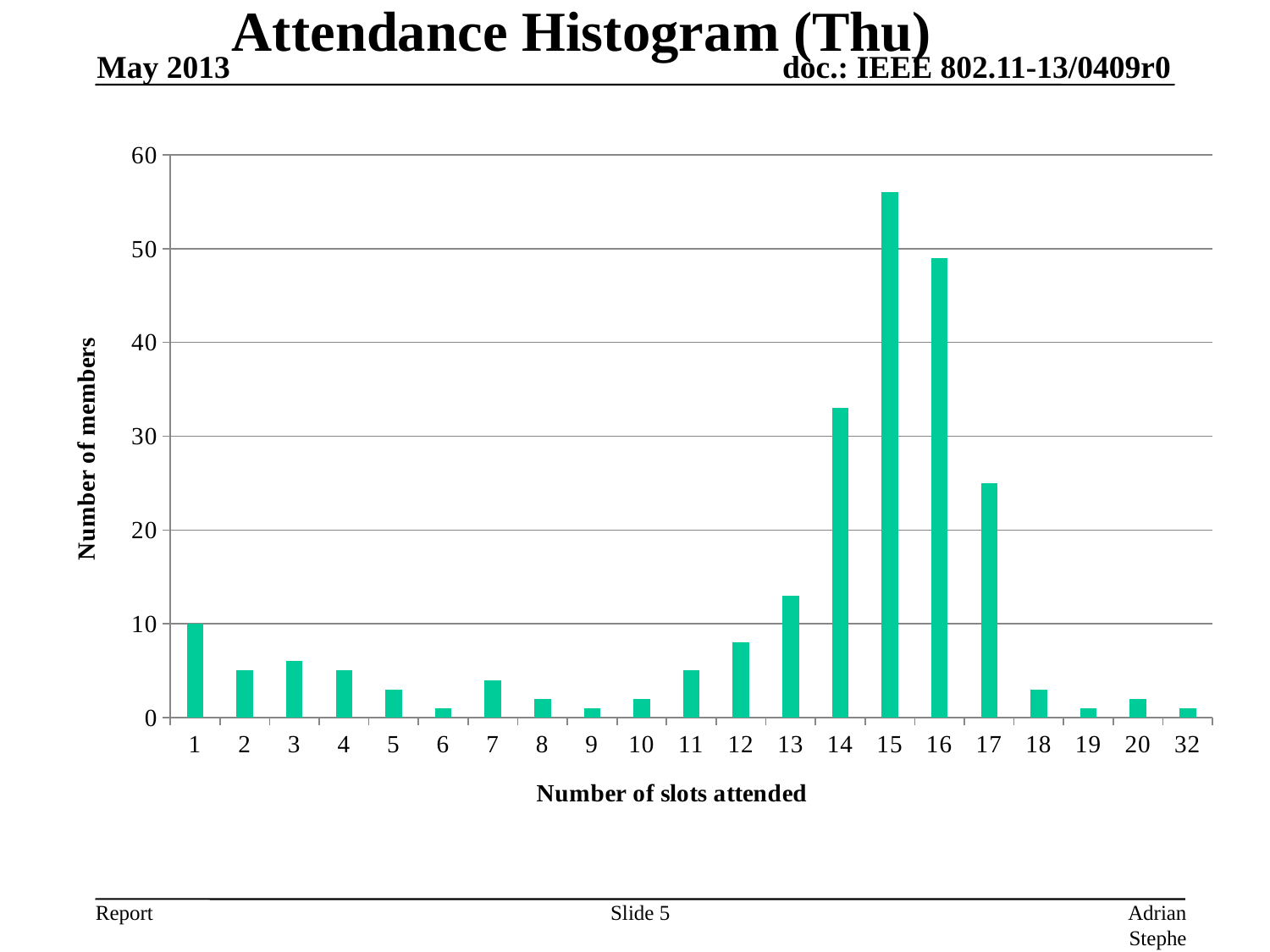
How many categories are shown on the x axis of the chart? 21 What is the label of the y axis? Number of members Which has more members: 1 slot attended or 2 slots attended? 1 Is the number of members for 14 slots attended greater or less than 30? greater Which has more members: 14 slots attended or 17 slots attended? 14 Is the number of members for 17 slots attended greater or less than 30? less Is the number of members for 13 slots attended greater or less than 10? greater What is the label of the x axis? Number of slots attended Which number of slots attended has the highest number of members? 15 What type of chart is shown on the slide? bar chart